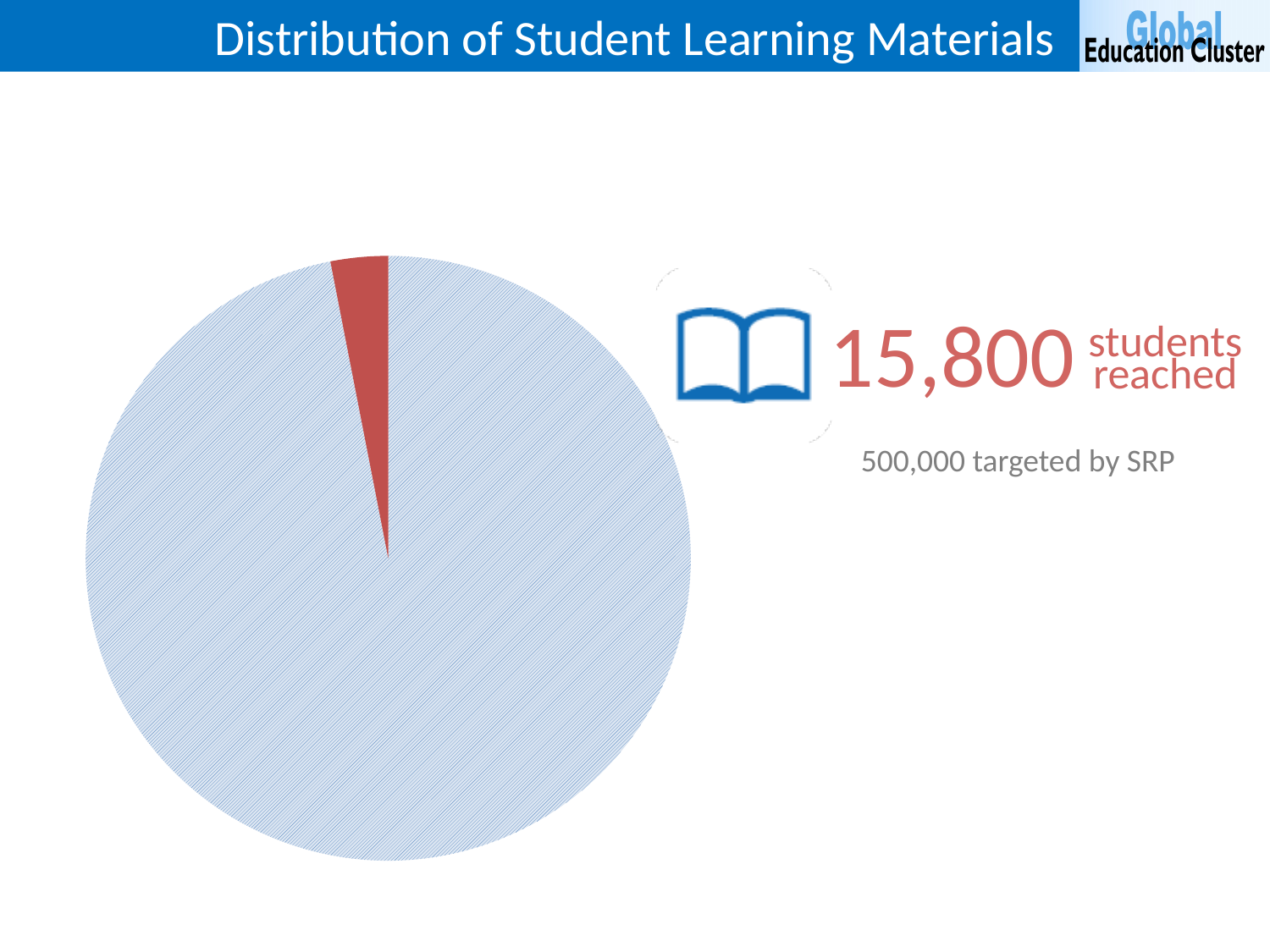
What is the title of the slide containing the pie chart? Distribution of Student Learning Materials Which slice of the pie chart is larger, the blue one or the red one? the blue one What kind of chart is shown on the slide? pie chart How many students are stated as targeted by SRP on the slide? 500,000 How many slices does the pie chart have? 2 Which slice takes up the smallest share of the pie chart? the red slice Which slice takes up the largest share of the pie chart? the blue slice What colour is the smaller slice of the pie chart? red Does the red slice represent more or less than half of the pie? less How many students reached are shown next to the pie chart? 15,800